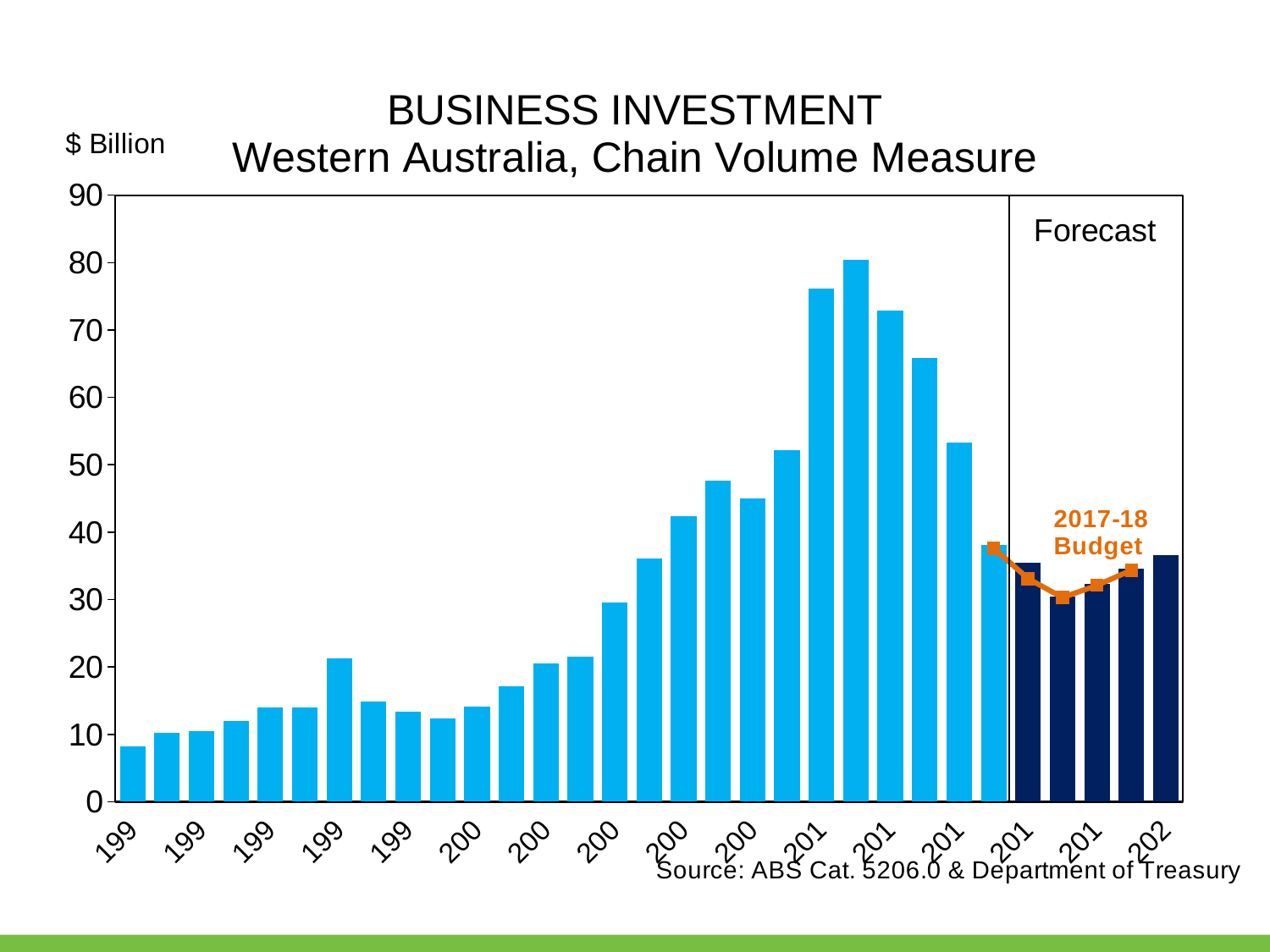
What is the title of the chart? BUSINESS INVESTMENT Western Australia, Chain Volume Measure What kind of chart is shown on the slide? bar and line chart Is the lowest point of the orange 2017-18 Budget line greater or less than 40? less Is the value of the tallest bar greater or less than 70? greater Is the value of the tallest bar greater or less than 90? less From the leftmost bar up to the tallest bar, do the values generally rise or fall? rise Which is larger: the tallest light-blue bar or the tallest dark-blue bar? the tallest light-blue bar What label is shown in the boxed region on the right side of the chart? Forecast From the tallest bar to the last light-blue bar, do the values rise or fall? fall